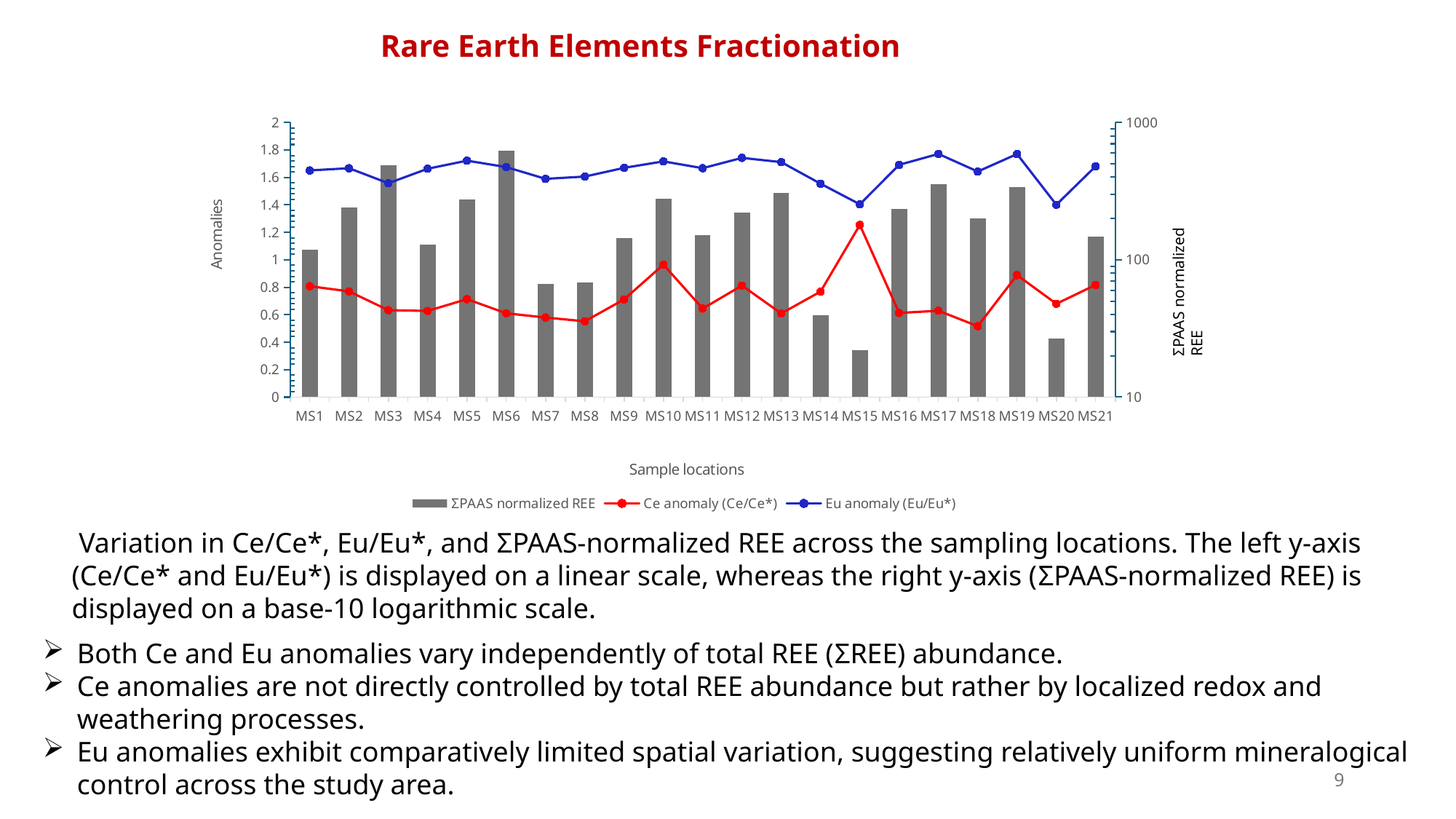
What is the label of the x axis of the chart? Sample locations Which sample location has the lowest ΣPAAS normalized REE bar? MS15 Is the Ce anomaly (Ce/Ce*) value for MS1 greater or less than 1? less How many sample locations are plotted along the x axis? 21 Which has the larger Eu anomaly (Eu/Eu*) value, MS3 or MS17? MS17 Which has the larger Ce anomaly (Ce/Ce*) value, MS14 or MS15? MS15 Which sample location has the highest ΣPAAS normalized REE bar? MS6 Is the Ce anomaly (Ce/Ce*) value for MS15 greater or less than 1? greater How many series does the legend list? 3 Which sample location has the highest Ce anomaly (Ce/Ce*) value? MS15 What kind of chart is shown on the slide? A combined bar and line chart Is the Eu anomaly (Eu/Eu*) value for MS15 greater or less than 1.6? less